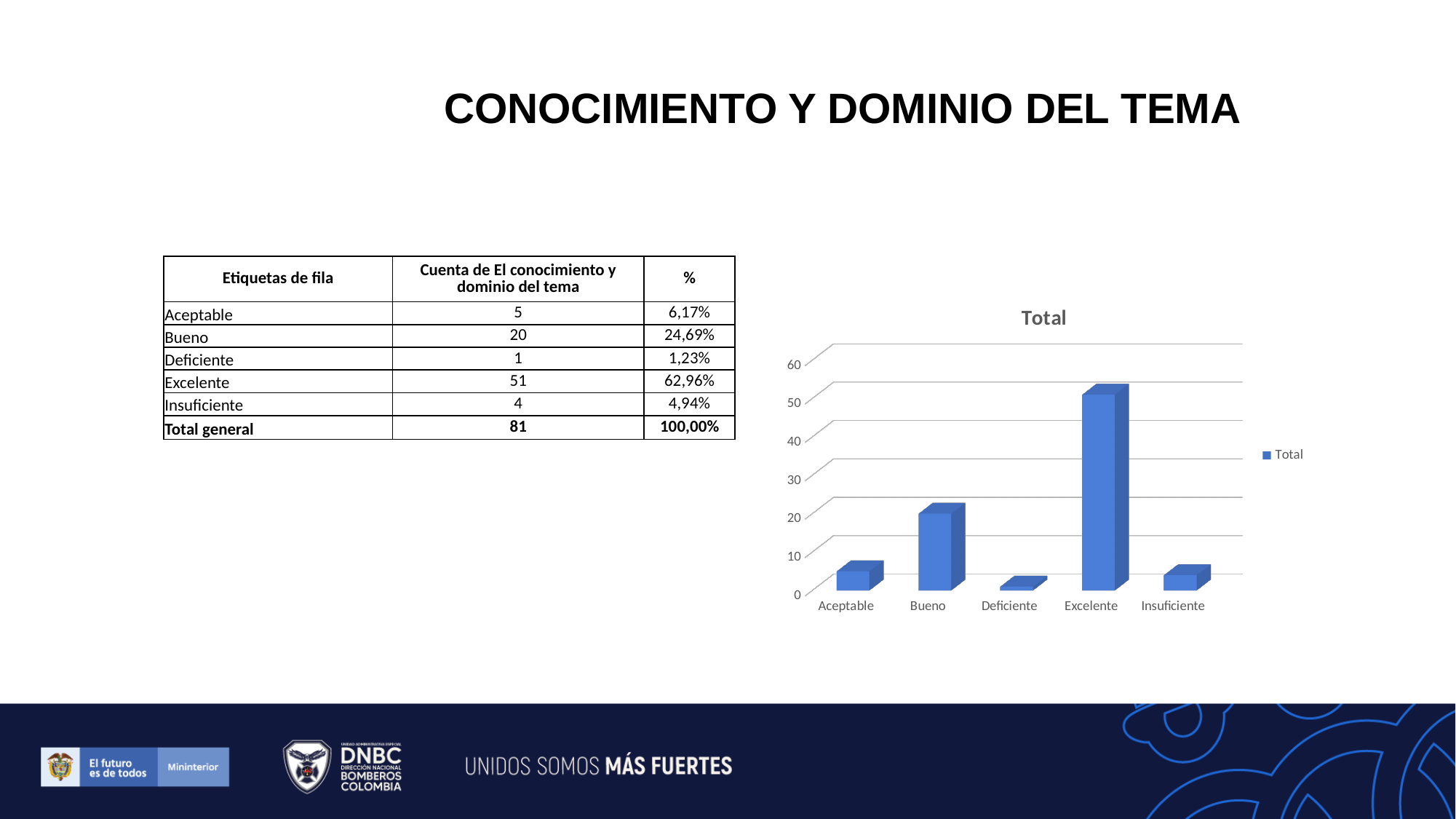
According to the table on the slide, what is the count for Excelente? 51 Is the value for Bueno greater or less than 30? less Which is larger, the bar for Bueno or the bar for Insuficiente? Bueno According to the table on the slide, what percentage corresponds to Bueno? 24,69% How many categories are shown on the x axis of the chart? 5 Is the value for Excelente greater or less than 40? greater Which category has the highest bar in the chart? Excelente How many series does the chart legend list? 1 Which category has the lowest bar in the chart? Deficiente What is the title of the chart? Total What type of chart is shown on the slide? bar chart Is the value for Aceptable greater or less than 10? less